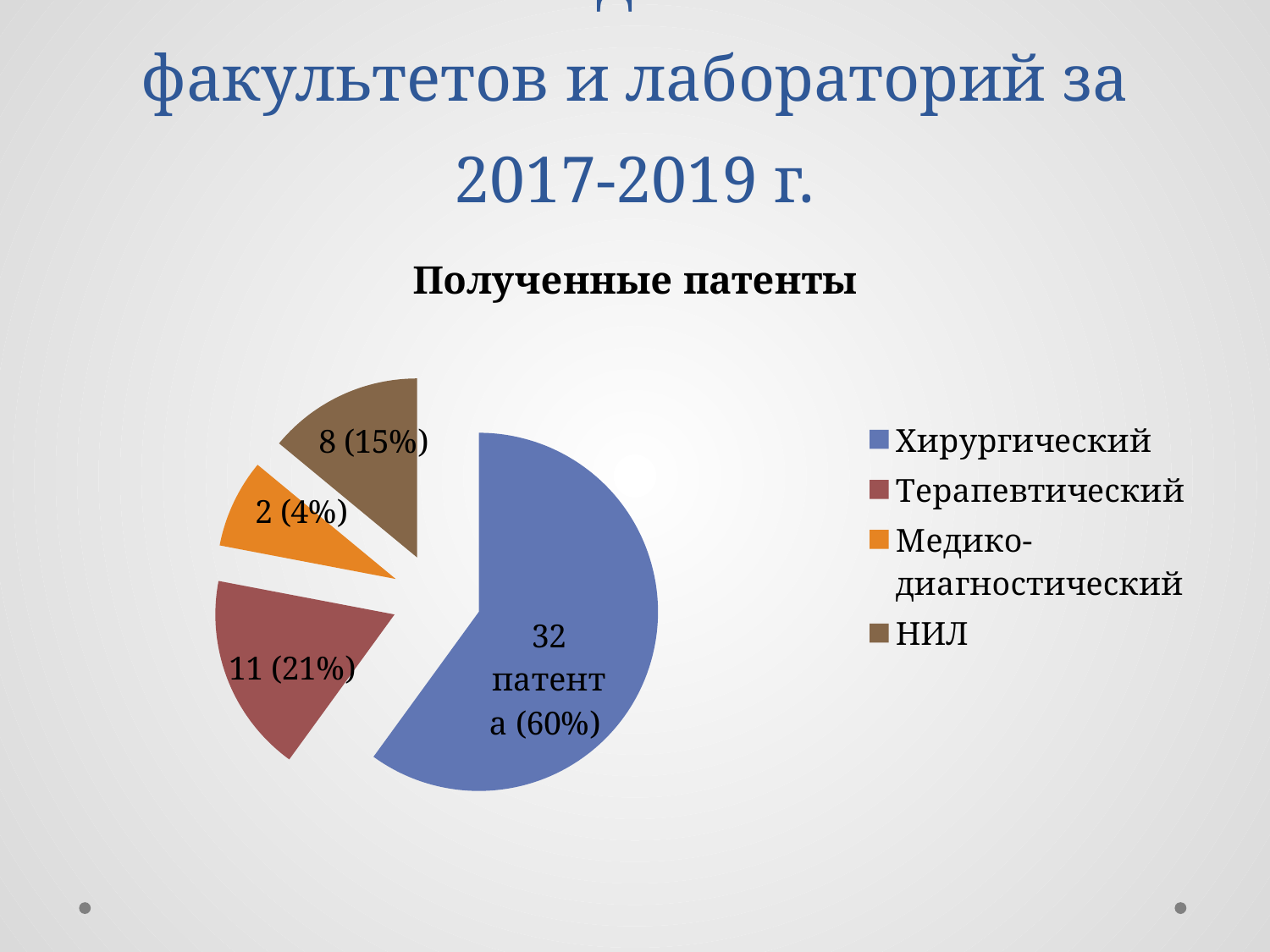
How many patents does the Терапевтический slice represent? 11 What is the title of the chart? Полученные патенты Which category has the smallest slice? Медико-диагностический How many patents does the НИЛ slice represent? 8 How many slices does the pie chart have? 4 What share of the pie does the Медико-диагностический slice have? 4% Which category has the largest slice? Хирургический What type of chart is shown on the slide? pie chart How many patents does the Хирургический slice represent? 32 What is the difference in patents between Терапевтический and НИЛ? 3 How many entries does the legend list? 4 What share of the pie does the Хирургический slice have? 60%